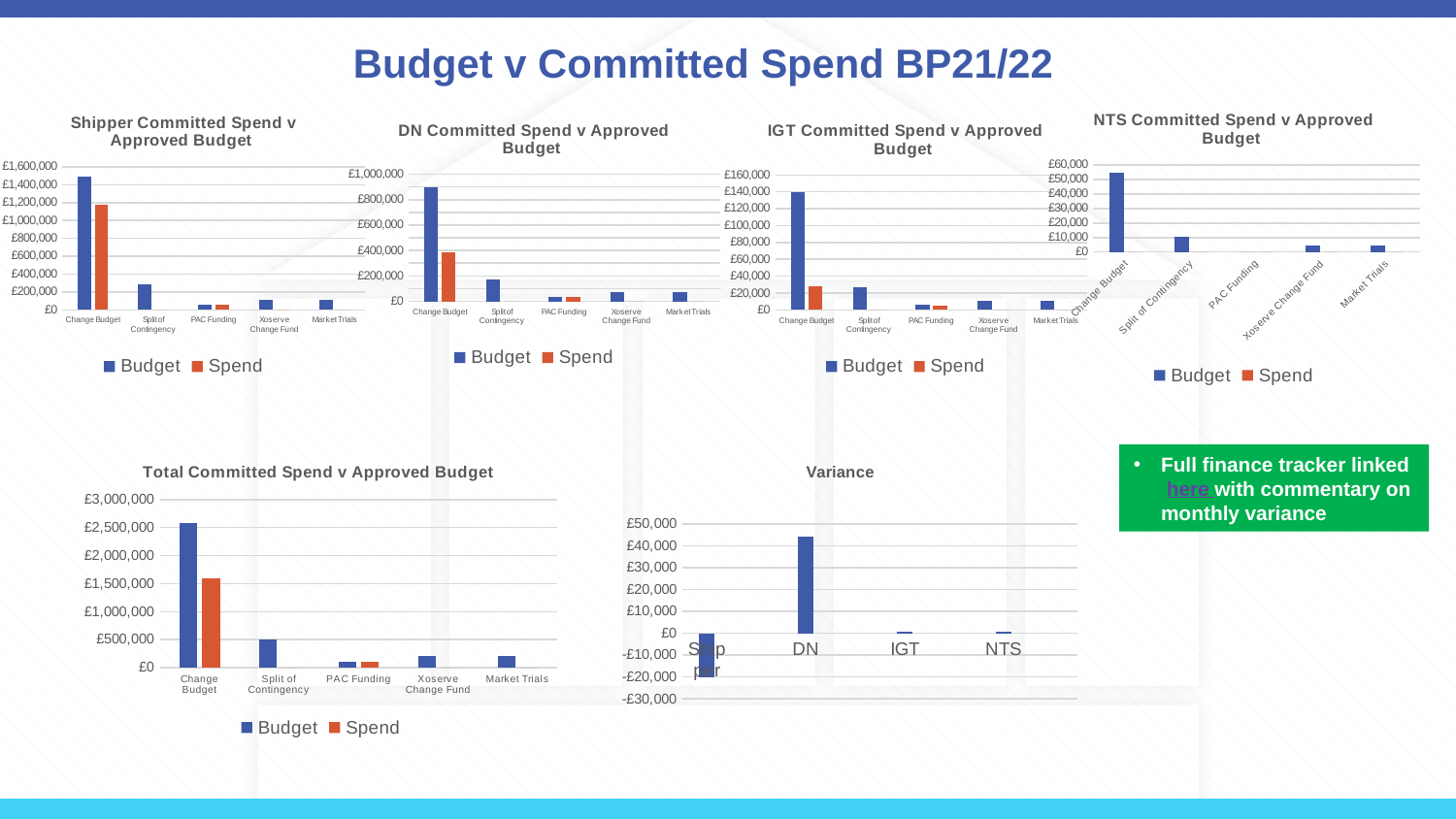
In the Total Committed Spend v Approved Budget chart, is the Budget value for Change Budget greater or less than £2,500,000? greater In the IGT Committed Spend v Approved Budget chart, is the Budget value for Change Budget greater or less than £120,000? greater In the Variance chart, which category has the highest value? DN In the Total Committed Spend v Approved Budget chart, is the Spend value for Change Budget greater or less than £2,000,000? less In the DN Committed Spend v Approved Budget chart, which is larger for Change Budget, Budget or Spend? Budget How many series does the legend of the Shipper Committed Spend v Approved Budget chart list? 2 How many categories are shown on the x axis of the Total Committed Spend v Approved Budget chart? 5 In the Shipper Committed Spend v Approved Budget chart, which category has the highest Budget value? Change Budget In the NTS Committed Spend v Approved Budget chart, which category has the highest Budget value? Change Budget